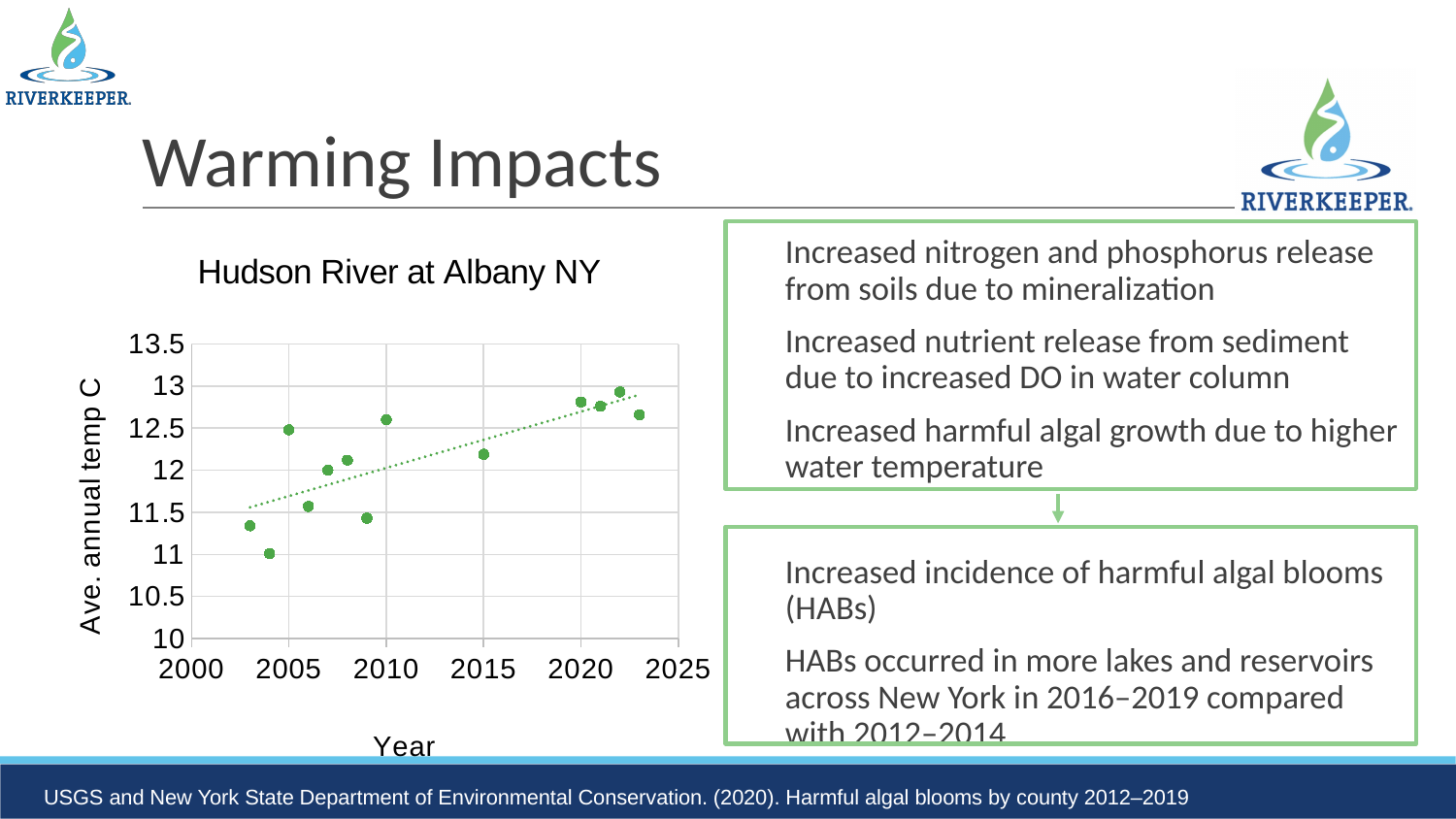
Do the plotted temperature values generally rise or fall as the year increases? Rise What is the title of the chart? Hudson River at Albany NY Is the value for the point at 2015 greater or less than 12? greater Is the value for the point at 2004 greater or less than 11.5? less Is the value for the point at 2009 greater or less than 12? less Which is larger, the value for 2004 or the value for 2020? 2020 How many data points are plotted on the chart? 13 What is the label of the y axis of the chart? Ave. annual temp C What kind of chart is shown on the slide? Scatter plot Which year has the lowest plotted average annual temperature? 2004